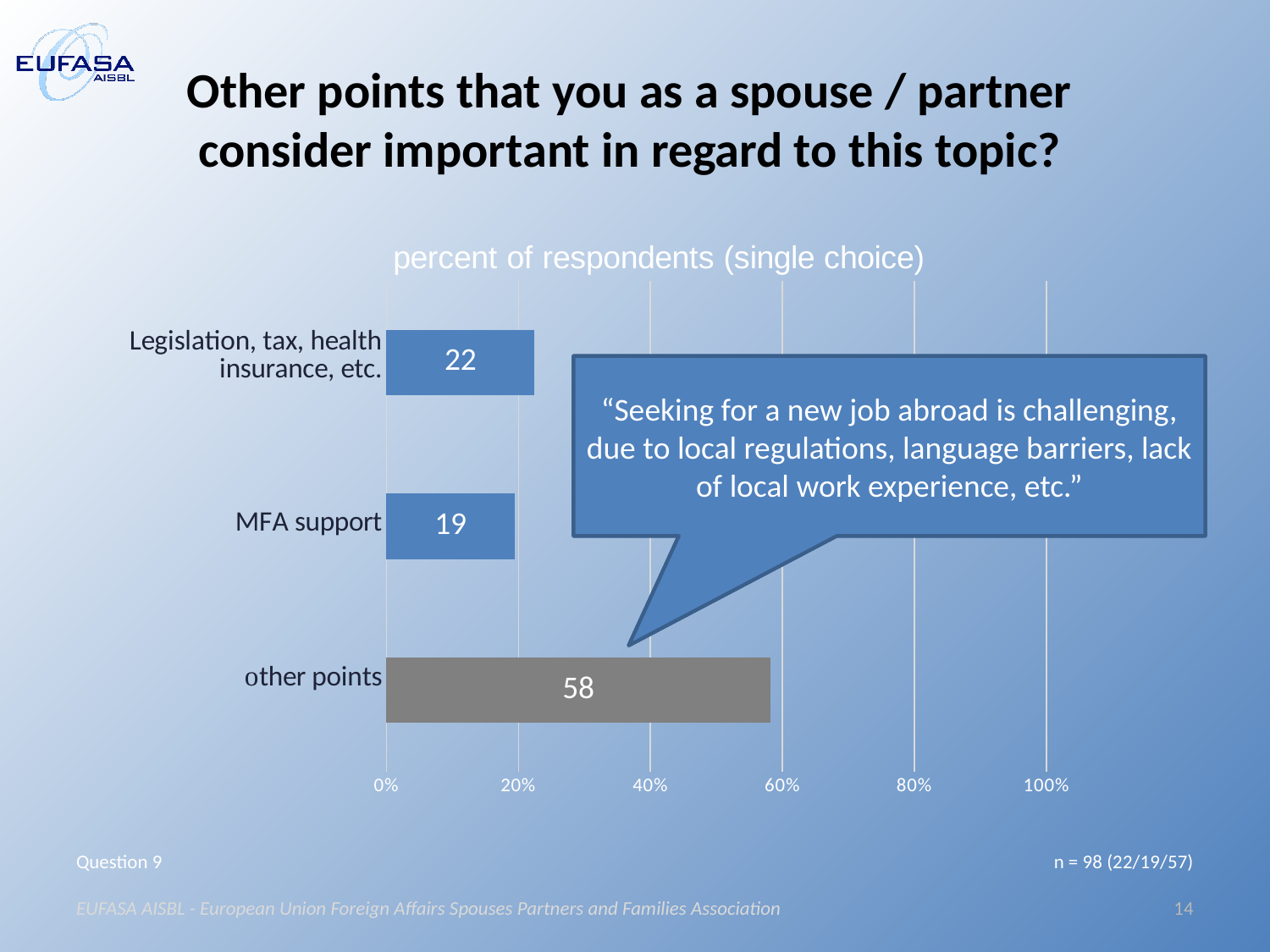
What is the difference between the values for "Legislation, tax, health insurance, etc." and "MFA support"? 3 What is the title of the chart? percent of respondents (single choice) Is the value for "other points" greater or less than 40%? greater Which category has the lowest value? MFA support What is the value for "Legislation, tax, health insurance, etc."? 22 What is the difference between the values for "other points" and "MFA support"? 39 What is the value for "MFA support"? 19 What is the value for "other points"? 58 Which is larger, the value for "Legislation, tax, health insurance, etc." or the value for "MFA support"? Legislation, tax, health insurance, etc. What kind of chart is shown on the slide? bar chart Which category has the highest value? other points How many categories are shown in the chart? 3